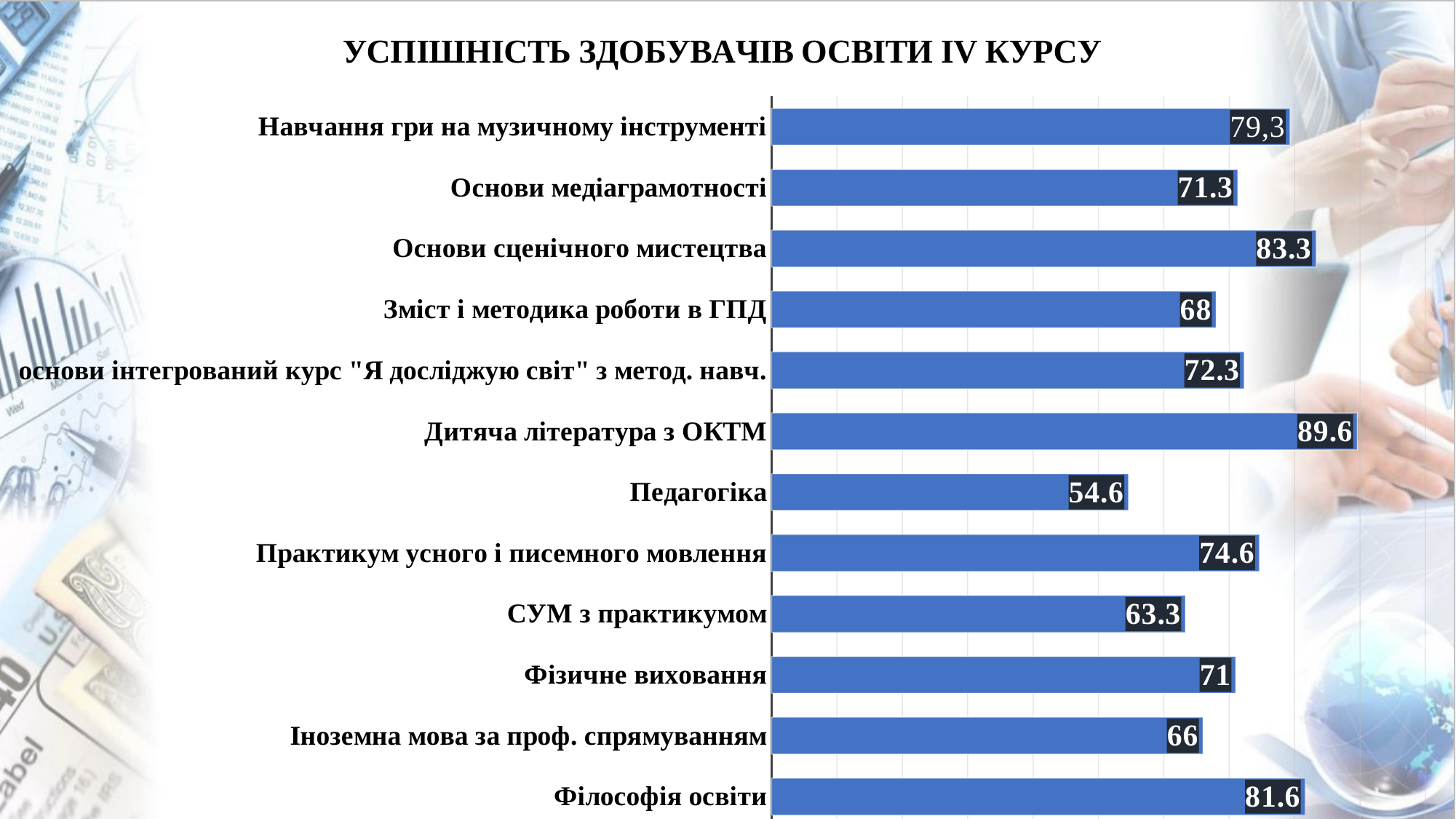
What is the value for Педагогіка? 54.6 What is the value for Філософія освіти? 81.6 Which category has the highest value? Дитяча література з ОКТМ What is the title of the chart? УСПІШНІСТЬ ЗДОБУВАЧІВ ОСВІТИ IV КУРСУ Which is larger, the value for Фізичне виховання or the value for Іноземна мова за проф. спрямуванням? Фізичне виховання How many categories are shown in the chart? 12 What is the difference between the values for Основи сценічного мистецтва and Основи медіаграмотності? 12 Which category has the lowest value? Педагогіка What kind of chart is shown on the slide? bar chart What is the difference between the values for Дитяча література з ОКТМ and Педагогіка? 35 What is the value for Дитяча література з ОКТМ? 89.6 What is the value for Навчання гри на музичному інструменті? 79,3